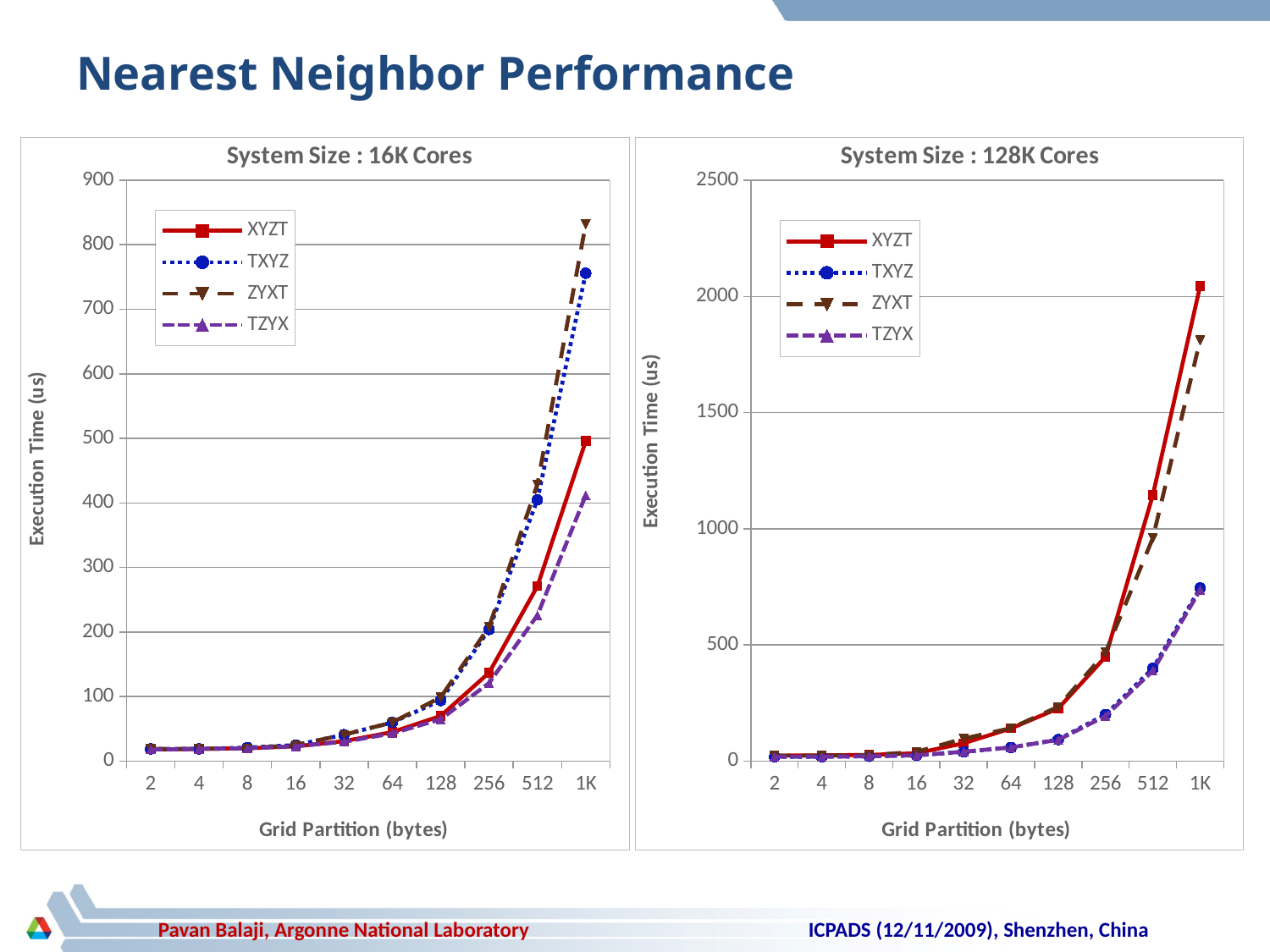
How many series does the legend of the 'System Size : 128K Cores' chart list? 4 What kind of chart is the 'System Size : 16K Cores' chart? line chart In the 'System Size : 128K Cores' chart, is the execution time for TXYZ at 1K bytes greater or less than 1000? less What is the y-axis label of the 'System Size : 16K Cores' chart? Execution Time (us) In the 'System Size : 128K Cores' chart, does the execution time for XYZT rise or fall as the grid partition size increases? rise In the 'System Size : 16K Cores' chart, is the execution time for ZYXT at 1K bytes greater or less than 800? greater In the 'System Size : 16K Cores' chart, which series has the lowest execution time at 1K bytes? TZYX In the 'System Size : 128K Cores' chart, is the execution time for XYZT at 1K bytes greater or less than 2000? greater In the 'System Size : 16K Cores' chart, which series has the highest execution time at 1K bytes? ZYXT How many grid partition sizes are plotted along the x axis of the 'System Size : 16K Cores' chart? 10 In the 'System Size : 128K Cores' chart, which series has the highest execution time at 1K bytes? XYZT In the 'System Size : 16K Cores' chart, which is larger at 1K bytes: the execution time for TXYZ or for XYZT? TXYZ